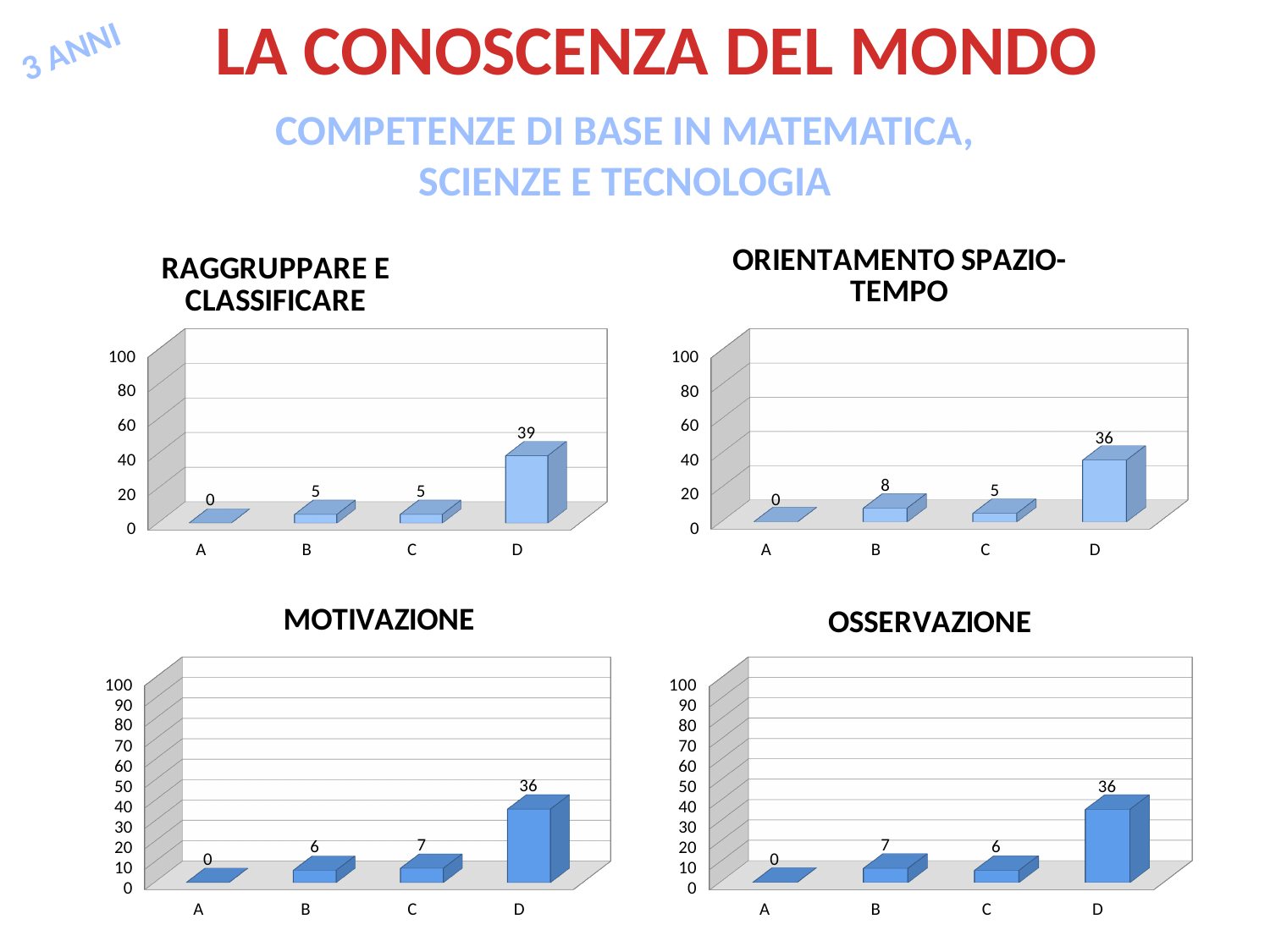
How many categories are shown in the MOTIVAZIONE chart? 4 What kind of chart is the OSSERVAZIONE chart? bar chart In the RAGGRUPPARE E CLASSIFICARE chart, what is the total of the values for B and C? 10 How many charts are shown on the slide? 4 In the MOTIVAZIONE chart, which category has the lowest value? A In the OSSERVAZIONE chart, which is larger, the value for B or the value for C? B In the MOTIVAZIONE chart, what is the value for C? 7 In the RAGGRUPPARE E CLASSIFICARE chart, what is the value for D? 39 In the ORIENTAMENTO SPAZIO-TEMPO chart, what is the difference between the values for D and B? 28 In the OSSERVAZIONE chart, which category has the highest value? D In the RAGGRUPPARE E CLASSIFICARE chart, is the value for D greater or less than 20? greater In the ORIENTAMENTO SPAZIO-TEMPO chart, what is the value for B? 8